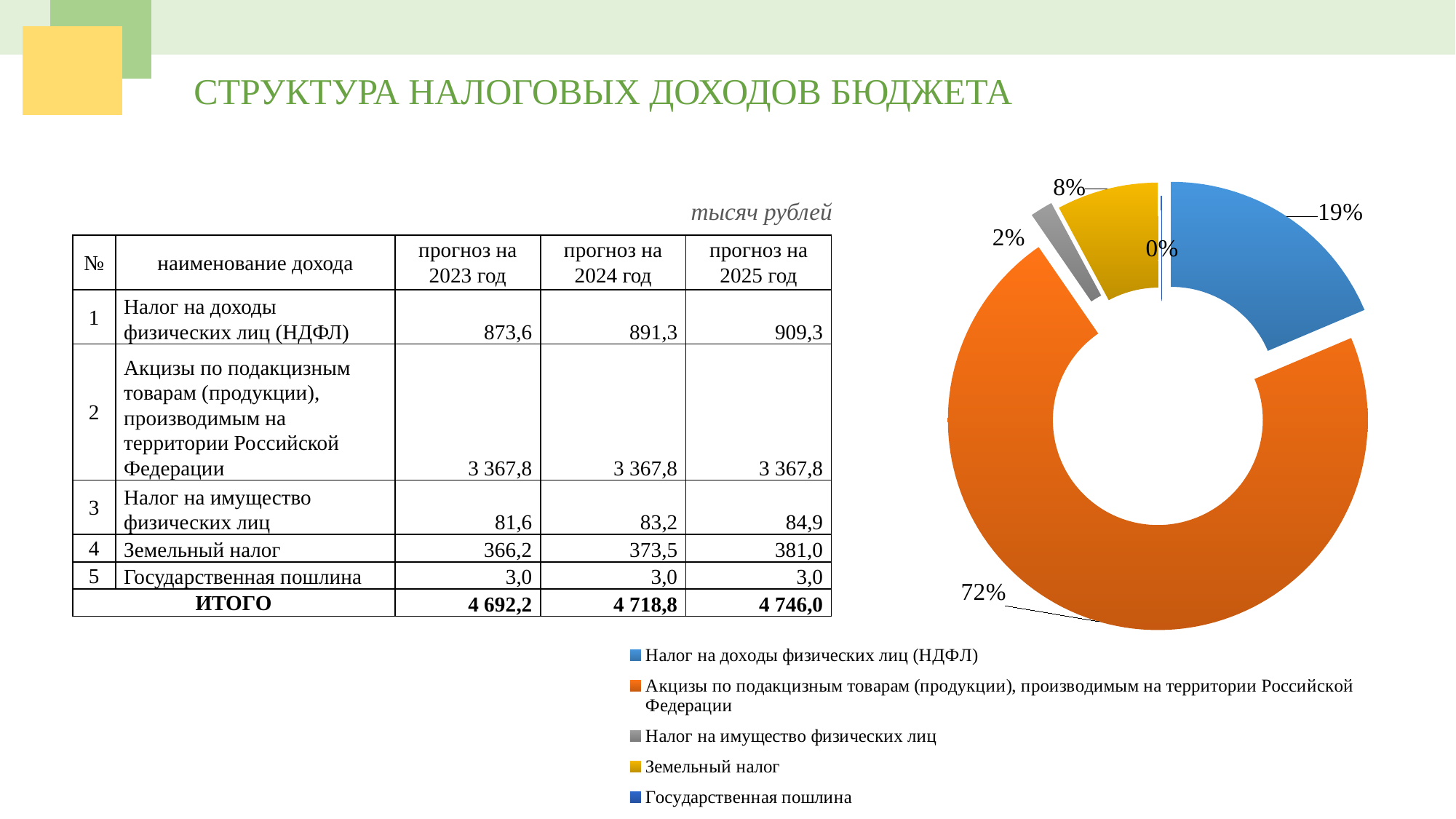
What colour is the slice for Земельный налог in the doughnut chart? Yellow How many categories does the legend of the doughnut chart list? 5 Which category has the smallest slice in the doughnut chart? Государственная пошлина What percentage is shown for Государственная пошлина in the doughnut chart? 0% Which slice is larger in the doughnut chart: Земельный налог or Налог на имущество физических лиц? Земельный налог What share of the doughnut chart does Акцизы по подакцизным товарам (продукции), производимым на территории Российской Федерации take? 72% By how many percentage points does the Акцизы slice exceed the НДФЛ slice in the doughnut chart? 53 What percentage is shown for Земельный налог in the doughnut chart? 8% What percentage is shown for Налог на доходы физических лиц (НДФЛ) in the doughnut chart? 19% Which category has the largest slice in the doughnut chart? Акцизы по подакцизным товарам (продукции), производимым на территории Российской Федерации What percentage is shown for Налог на имущество физических лиц in the doughnut chart? 2% What type of chart is shown on the right of the slide? Doughnut (pie) chart